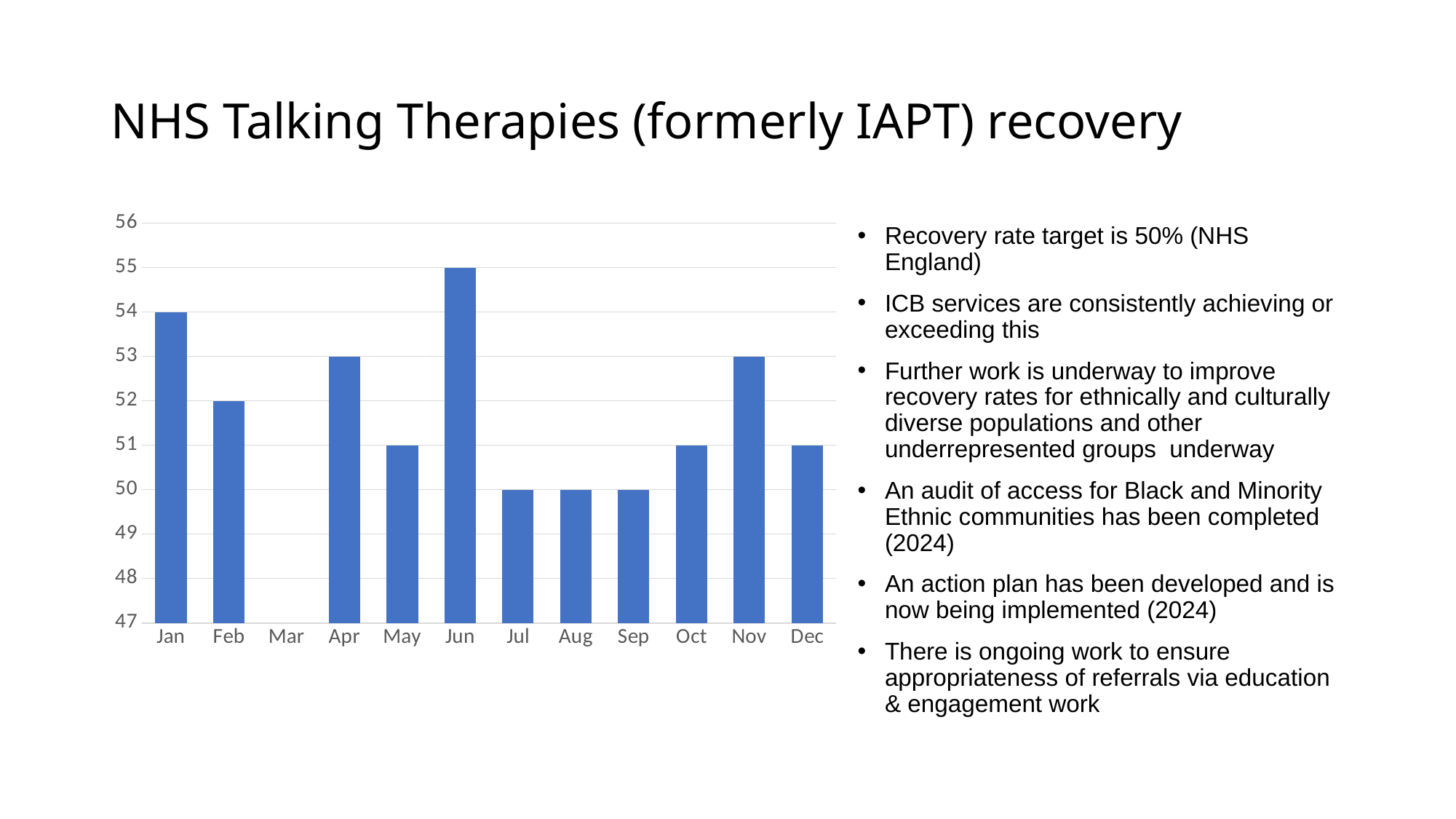
What is the value for Oct? 51 Which month has the highest value? Jun What is the difference between the values for Jun and Jul? 5 Which is larger, the value for Apr or the value for May? Apr What kind of chart is shown on the slide? bar chart What is the difference between the values for Jan and Feb? 2 What is the value for Jan? 54 Which is larger, the value for Nov or the value for Dec? Nov How many months are shown on the x axis? 12 Is the value for Jun greater or less than 52? greater What is the value for Jun? 55 Which month on the x axis has no bar plotted? Mar